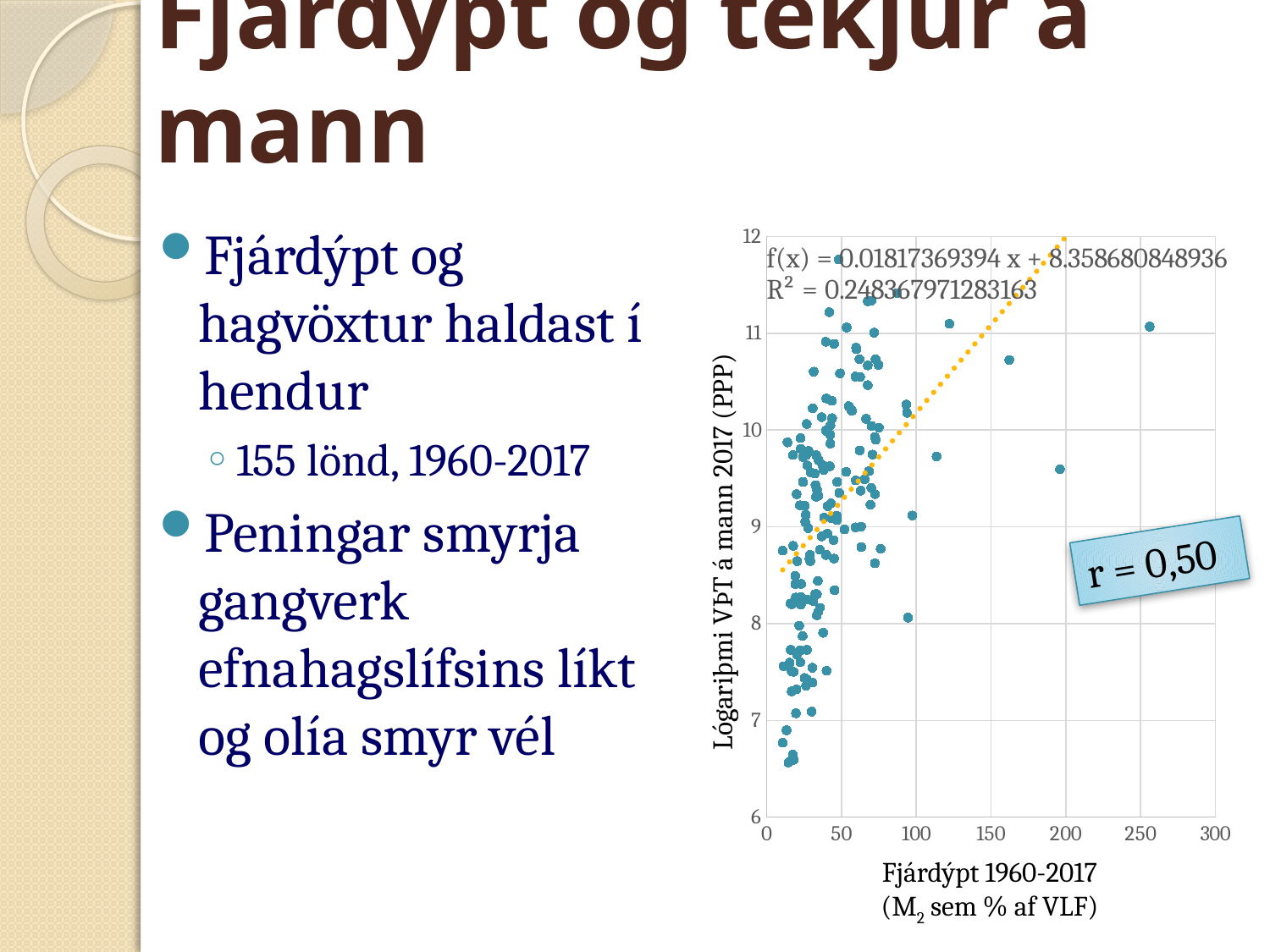
What kind of chart is shown on the slide? scatter chart What is the R² value printed on the chart? 0.248367971283163 According to the slide, how many countries are plotted in the scatter chart? 155 What is the maximum value shown on the x axis of the chart? 300 What is the intercept of the fitted line f(x) printed on the chart? 8.358680848936 What is the label of the y axis of the chart? Lógariþmi VÞT á mann 2017 (PPP) What is the slope of the fitted line f(x) printed on the chart? 0.01817369394 Is the y value of the point at roughly x = 200 greater or less than 10? less What is the correlation coefficient r shown on the chart? r = 0,50 Is the y value of the lowest point in the scatter chart greater or less than 7? less What is the label of the x axis of the chart? Fjárdýpt 1960-2017 (M2 sem % af VLF) Does the trendline in the scatter chart rise or fall as financial depth (x axis) increases? rises